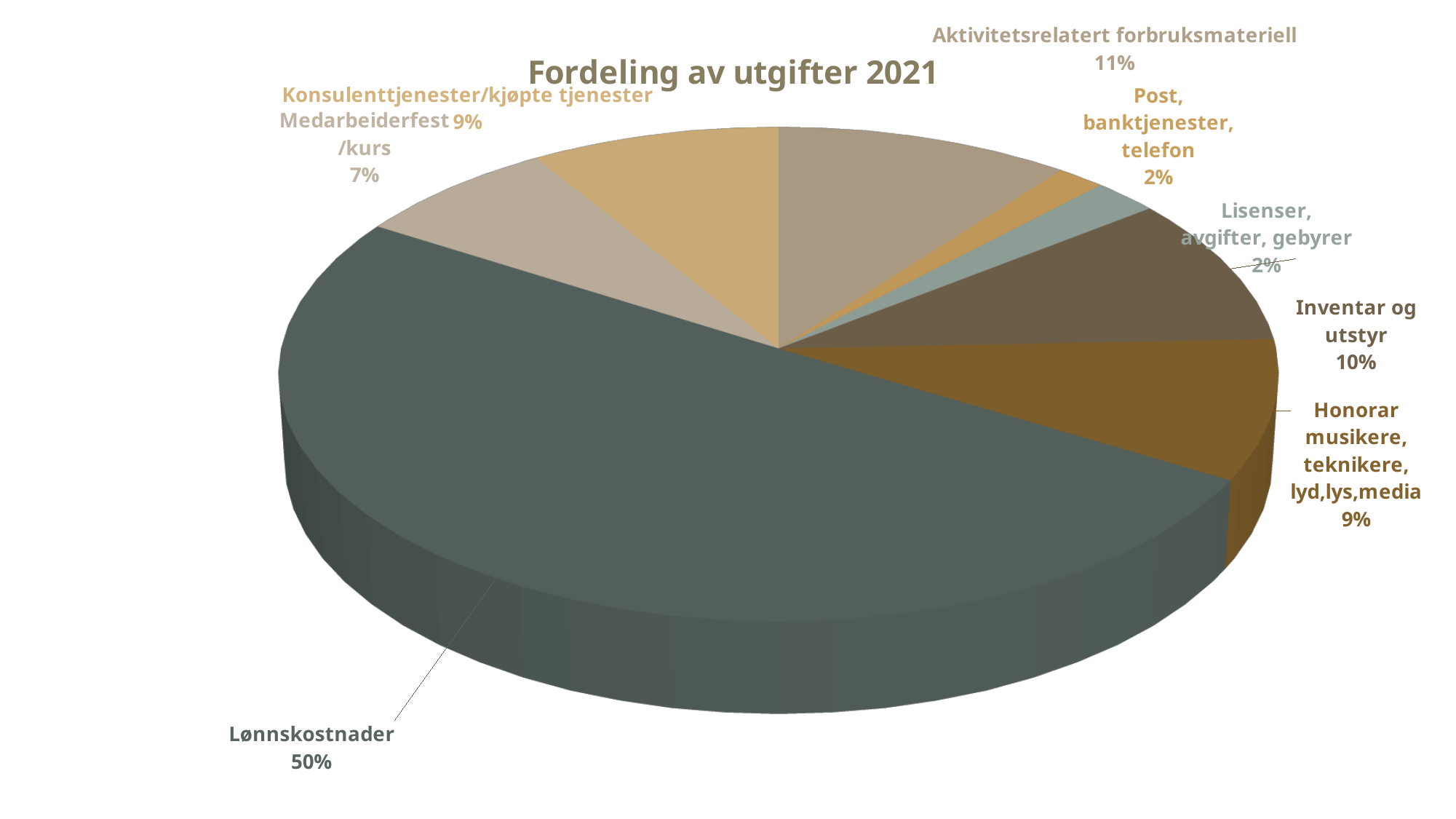
What share of the pie is Inventar og utstyr? 10% Which category has the largest share of the pie? Lønnskostnader What share of the pie is Medarbeiderfest/kurs? 7% What share of the pie is Post, banktjenester, telefon? 2% Which is larger, the share for Inventar og utstyr or the share for Medarbeiderfest/kurs? Inventar og utstyr How many slices does the pie chart have? 8 What kind of chart is shown on the slide? pie chart What is the difference in percentage points between Konsulenttjenester/kjøpte tjenester and Lisenser, avgifter, gebyrer? 7 What is the title of the chart? Fordeling av utgifter 2021 What is the difference in percentage points between Lønnskostnader and Aktivitetsrelatert forbruksmateriell? 39